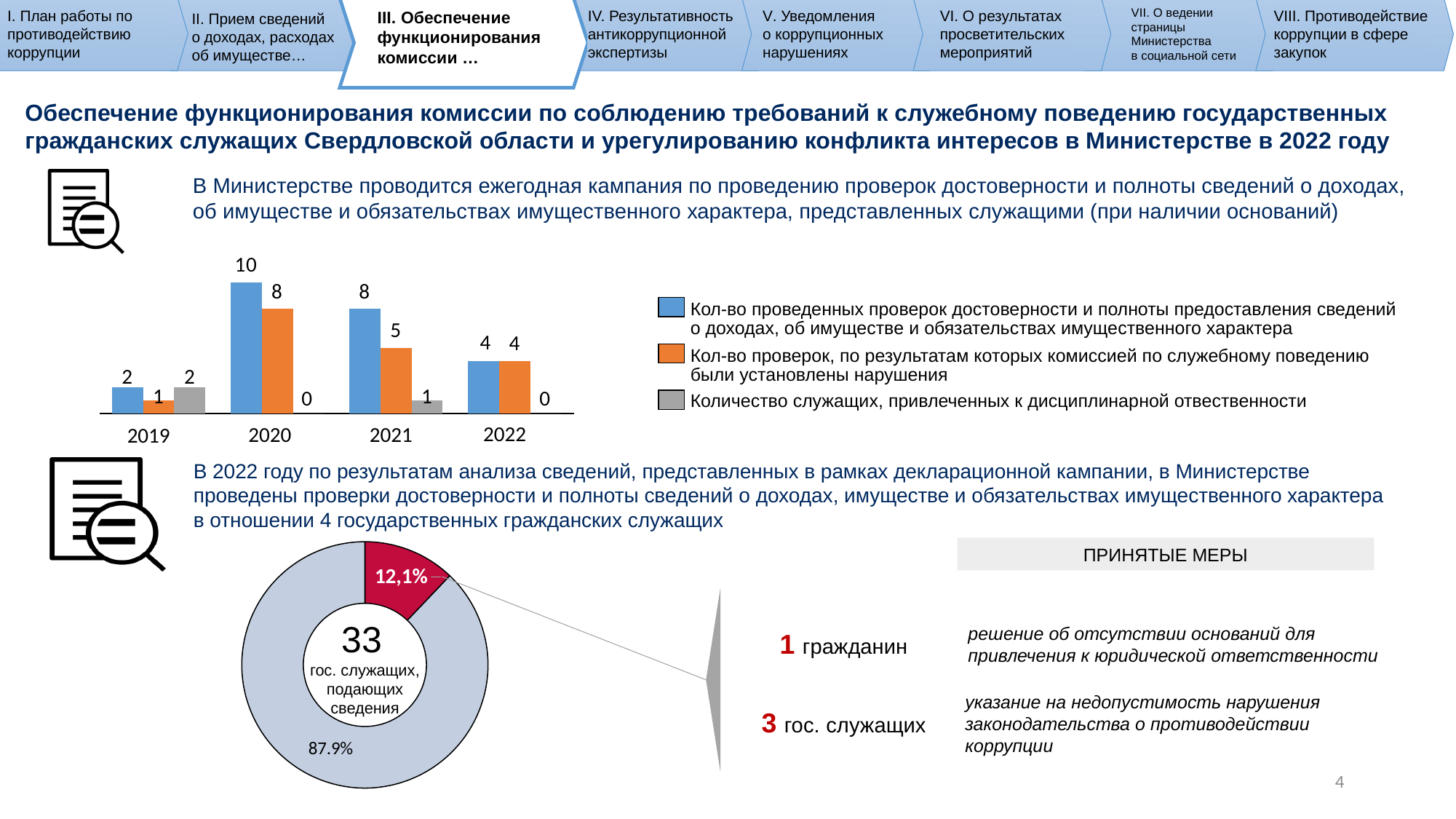
In the bar chart at the top of the slide, what is the value of the orange series (verifications where violations were found) for 2021? 5 In the bar chart at the top of the slide, what is the value of the grey series (employees brought to disciplinary responsibility) for 2019? 2 How many series does the legend of the bar chart at the top of the slide list? 3 What number is shown in the centre of the donut chart at the bottom of the slide? 33 In the bar chart at the top of the slide, which year has the highest value for the blue series? 2020 In the donut chart at the bottom of the slide, what share is shown for the red slice? 12,1% In the bar chart at the top of the slide, which year has the lowest value for the orange series? 2019 In the bar chart at the top of the slide, what is the difference between the blue and orange values for 2021? 3 In the bar chart at the top of the slide, is the blue value for 2020 larger or smaller than the blue value for 2022? larger How many years (categories) are shown on the x axis of the bar chart at the top of the slide? 4 What type of chart is shown at the top of the slide? bar chart In the bar chart at the top of the slide, what is the value of the blue series (number of verifications conducted) for 2020? 10